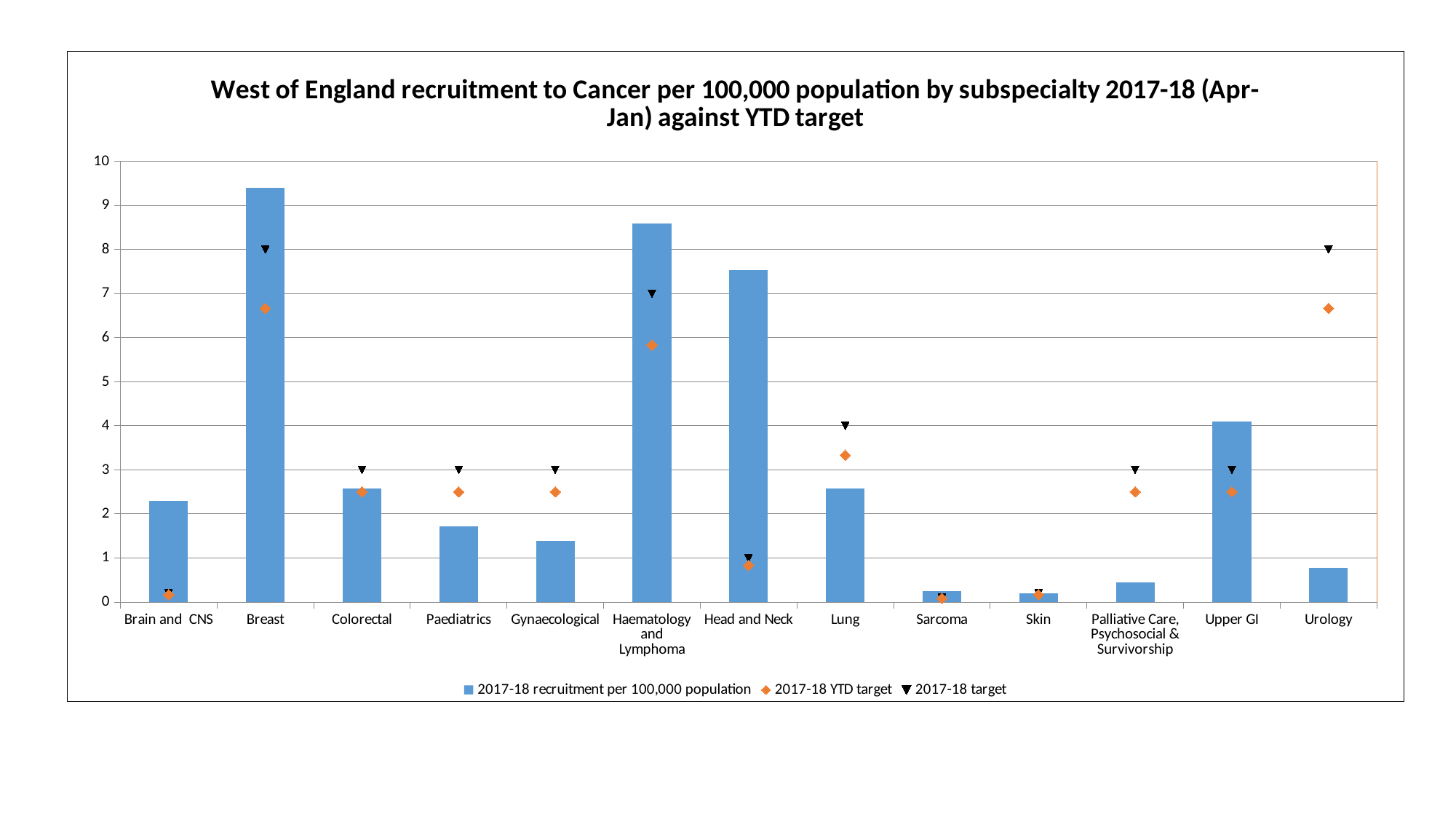
Is the 2017-18 recruitment per 100,000 population for Lung greater or less than 3? less Which has the larger 2017-18 recruitment per 100,000 population, Paediatrics or Gynaecological? Paediatrics Is the 2017-18 recruitment per 100,000 population for Breast greater or less than 9? greater Is the 2017-18 recruitment per 100,000 population for Urology greater or less than 1? less How many series does the legend list? 3 Which subspecialty has the highest 2017-18 recruitment per 100,000 population? Breast What kind of chart is shown on the slide? bar chart What is the 2017-18 target value for Breast? 8 What marker shape does the legend use for the 2017-18 YTD target series? orange diamond Which has the larger 2017-18 recruitment per 100,000 population, Haematology and Lymphoma or Head and Neck? Haematology and Lymphoma How many subspecialty categories are shown on the x axis? 13